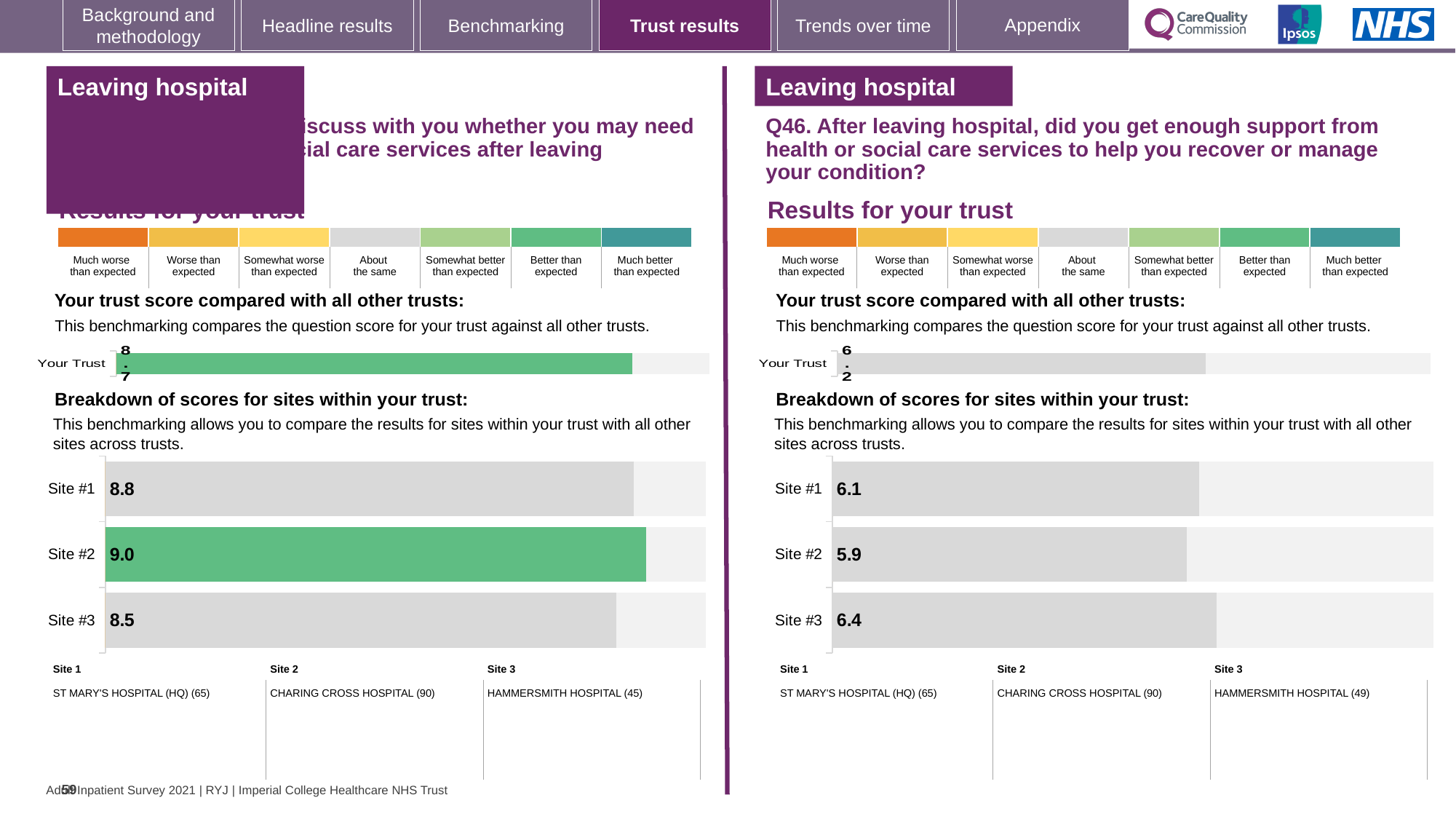
How many sites are shown in the left-hand site breakdown chart? 3 In the Q46 site breakdown chart on the right, which site has the lowest score? Site #2 In the left-hand site breakdown chart, what is the score for Site #2? 9.0 In the left-hand site breakdown chart, which site has the highest score? Site #2 In the Q46 site breakdown chart on the right, which has the larger score, Site #1 or Site #3? Site #3 In the Q46 site breakdown chart on the right, what is the score for Site #3? 6.4 In the left-hand site breakdown chart, which site's bar is coloured green? Site #2 In the Q46 'Your Trust' bar chart on the right, what is the trust score shown? 6.2 In the left-hand site breakdown chart, what is the difference between the scores for Site #2 and Site #3? 0.5 In the Q46 site breakdown chart on the right, what is the difference between the scores for Site #3 and Site #2? 0.5 In the left-hand 'Your Trust' bar chart, what is the trust score shown? 8.7 What kind of chart is used for the site breakdown on the right-hand side of the slide? Bar chart